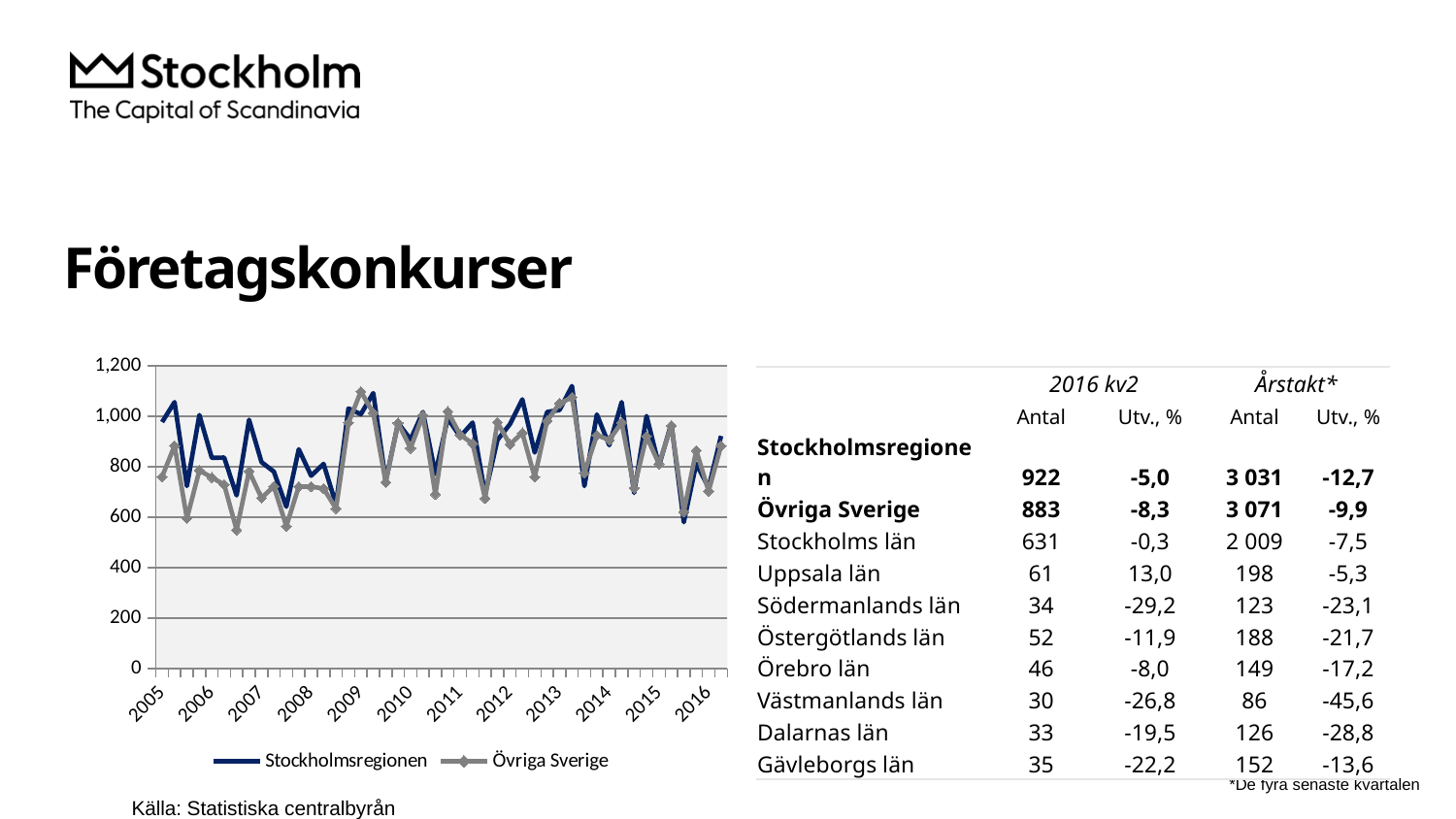
What is the highest value shown on the chart's vertical axis? 1,200 How many years are labelled along the chart's x axis? 12 What are the two series named in the chart's legend? Stockholmsregionen and Övriga Sverige How many series does the chart's legend list? 2 Is the peak value for Övriga Sverige around 2009 greater or less than 1,000? greater Do the values for Övriga Sverige rise or fall from late 2008 to the 2009 peak? rise Is the first 2005 value for Övriga Sverige greater or less than 600? greater Is the lowest value for Övriga Sverige around 2007 greater or less than 800? less What kind of chart is shown on the slide? Line chart At the first point in 2005, which series has the higher value, Stockholmsregionen or Övriga Sverige? Stockholmsregionen